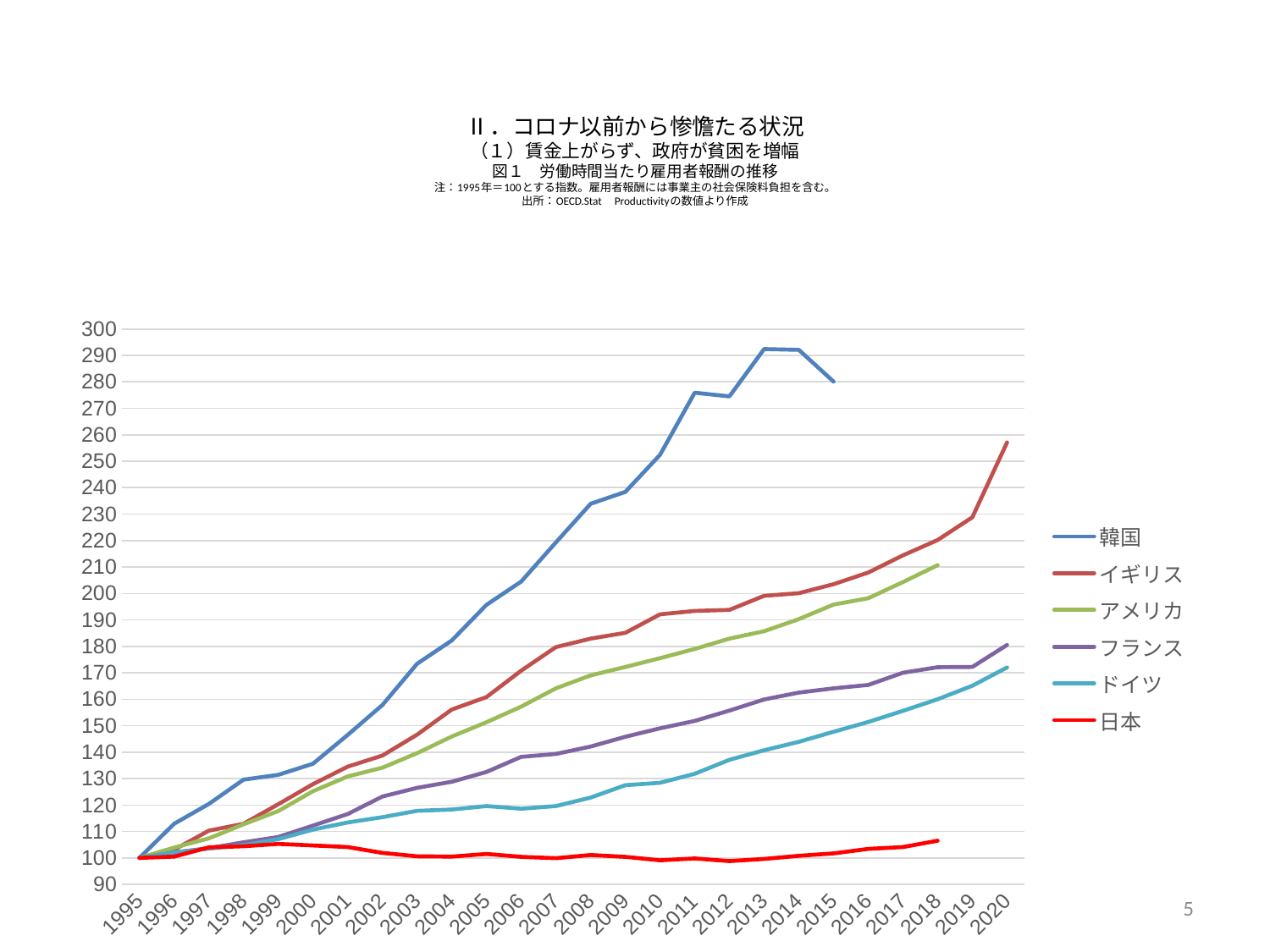
Is the value for アメリカ in 2018 greater or less than 200? greater Is the value for 日本 in 2018 greater or less than 110? less Does the 韓国 line rise or fall from 1995 to 2013? rise What colour is the 日本 line? red Is the value for 韓国 in 2011 greater or less than 270? greater What kind of chart is shown on the slide? line chart In 2020, which is larger, the value for イギリス or the value for フランス? イギリス Which series reaches the highest value on the chart? 韓国 How many series does the legend list? 6 How many years are labelled along the x axis? 26 Which series has the highest value in 2020? イギリス